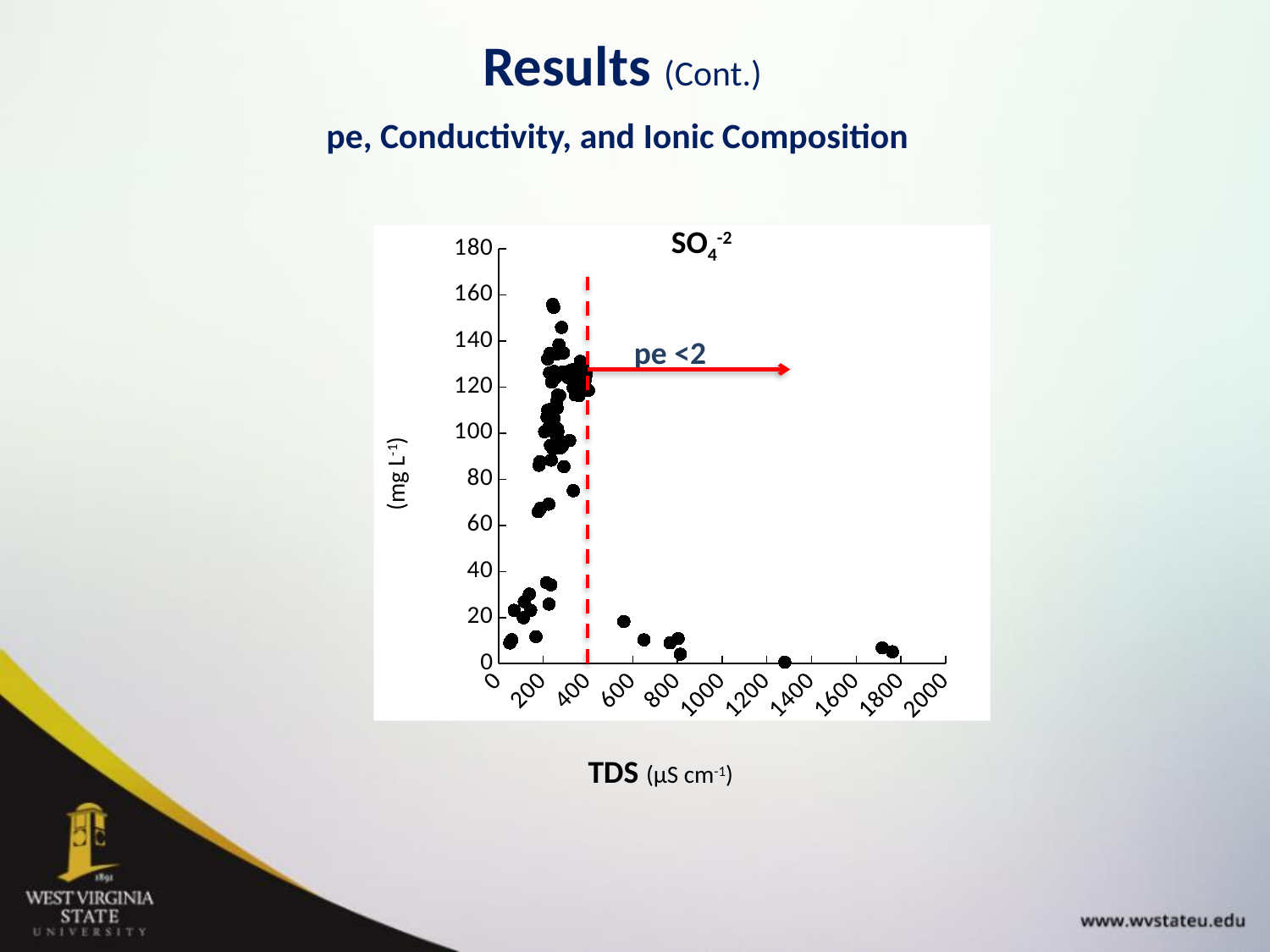
What kind of chart is shown on the slide? scatter plot What quantity is plotted on the x axis of the chart? TDS (µS cm-1) What is the highest value shown on the y axis of the chart? 180 Is the highest SO4-2 value plotted on the chart greater or less than 140? greater What label is written next to the red arrow on the chart? pe <2 Is the SO4-2 value for the point near TDS 600 greater or less than 40? less Do the SO4-2 values generally rise or fall as TDS increases beyond the red dashed line? fall What is the title of the chart? SO4-2 Is the SO4-2 value for the points near TDS 1800 greater or less than 20? less Are the points with the highest SO4-2 values found at TDS below 400 or above 400? below 400 What is the highest value shown on the x axis of the chart? 2000